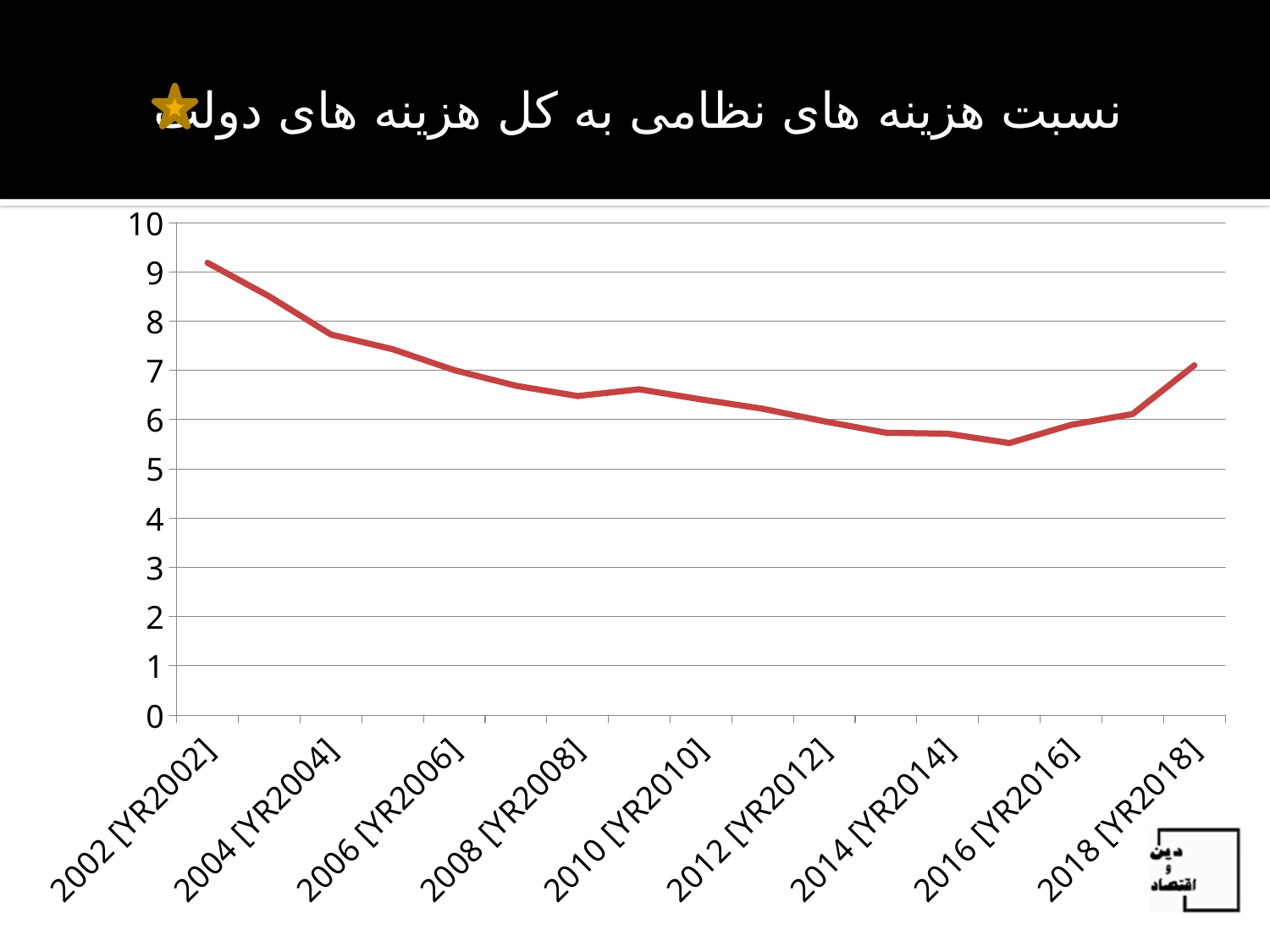
Is the value for 2008 [YR2008] greater or less than 7? less Is the value for 2002 [YR2002] greater or less than 8? greater Which year has the highest value on the chart? 2002 [YR2002] Does the line generally rise or fall from 2002 to 2016? fall What colour is the line on the chart? red Which is larger, the value for 2002 [YR2002] or the value for 2018 [YR2018]? 2002 [YR2002] Which is larger, the value for 2010 [YR2010] or the value for 2014 [YR2014]? 2010 [YR2010] Is the value for 2018 [YR2018] greater or less than 6? greater What kind of chart is shown on the slide? line chart How many year labels are shown on the x axis? 9